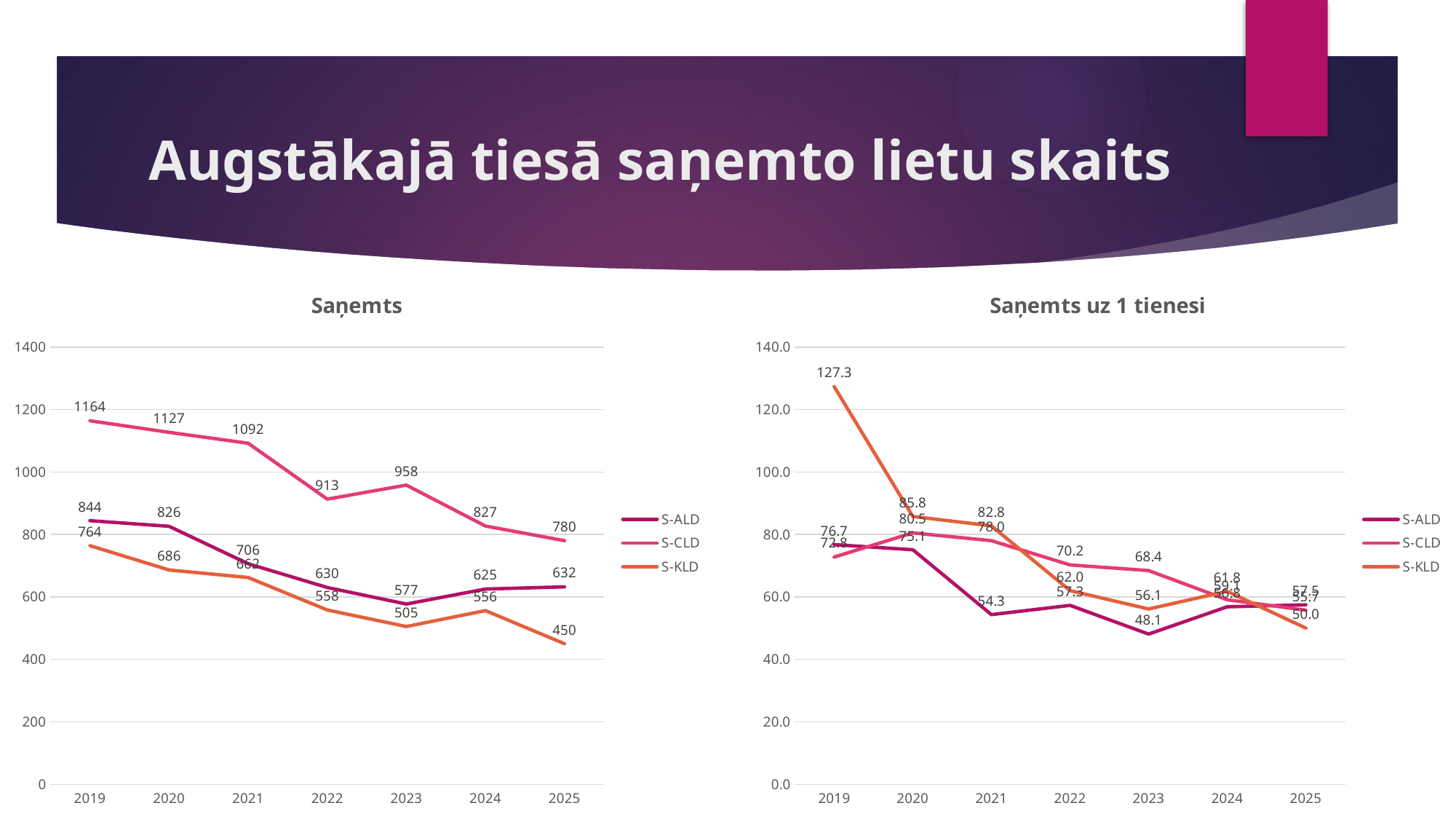
In the 'Saņemts' chart, what is the value for S-CLD in 2019? 1164 In the 'Saņemts' chart, what is the value for S-KLD in 2025? 450 What type of chart is the 'Saņemts' chart? Line chart In the 'Saņemts uz 1 tienesi' chart, which series has the lowest value in 2021? S-ALD In the 'Saņemts' chart, what is the difference between S-CLD and S-ALD in 2025? 148 In the 'Saņemts uz 1 tienesi' chart, what is the value for S-KLD in 2019? 127.3 In the 'Saņemts' chart, which year has the highest value for S-CLD? 2019 In the 'Saņemts uz 1 tienesi' chart, what is the value for S-ALD in 2023? 48.1 In the 'Saņemts' chart, how many years are shown on the x axis? 7 In the 'Saņemts' chart, what is the value for S-ALD in 2023? 577 In the 'Saņemts uz 1 tienesi' chart, how many series does the legend list? 3 In the 'Saņemts' chart, which is larger in 2022: S-ALD or S-KLD? S-ALD